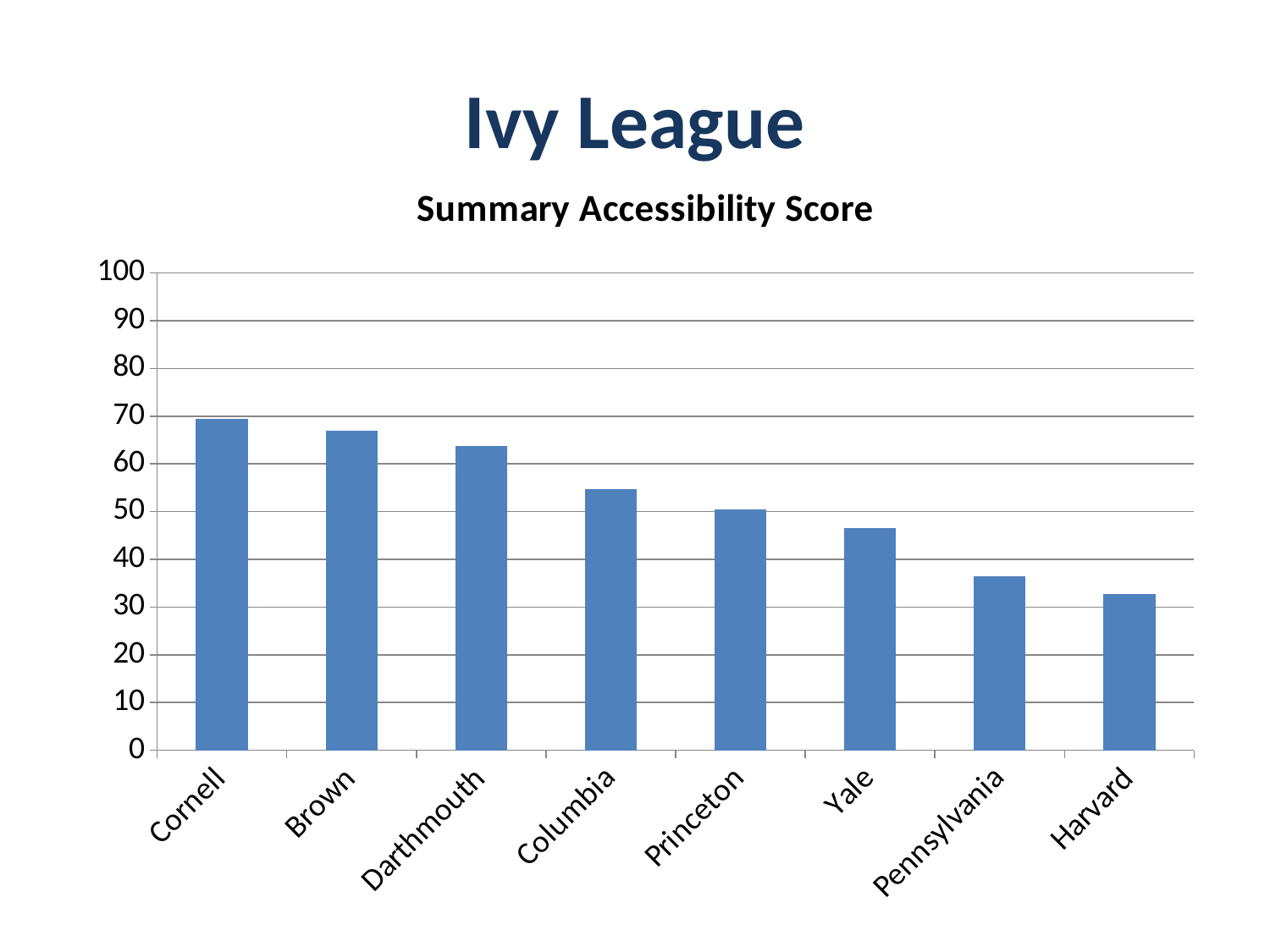
What is the title of the chart? Summary Accessibility Score How many universities are shown on the x axis? 8 Which university has the lowest Summary Accessibility Score? Harvard Which has a higher score, Columbia or Princeton? Columbia Is the value for Cornell greater or less than 60? greater Which has a higher score, Yale or Darthmouth? Darthmouth Which university has the highest Summary Accessibility Score? Cornell Is the value for Pennsylvania greater or less than 30? greater Is the value for Harvard greater or less than 40? less Do the values rise or fall from left to right along the x axis? fall What type of chart is shown on the slide? bar chart